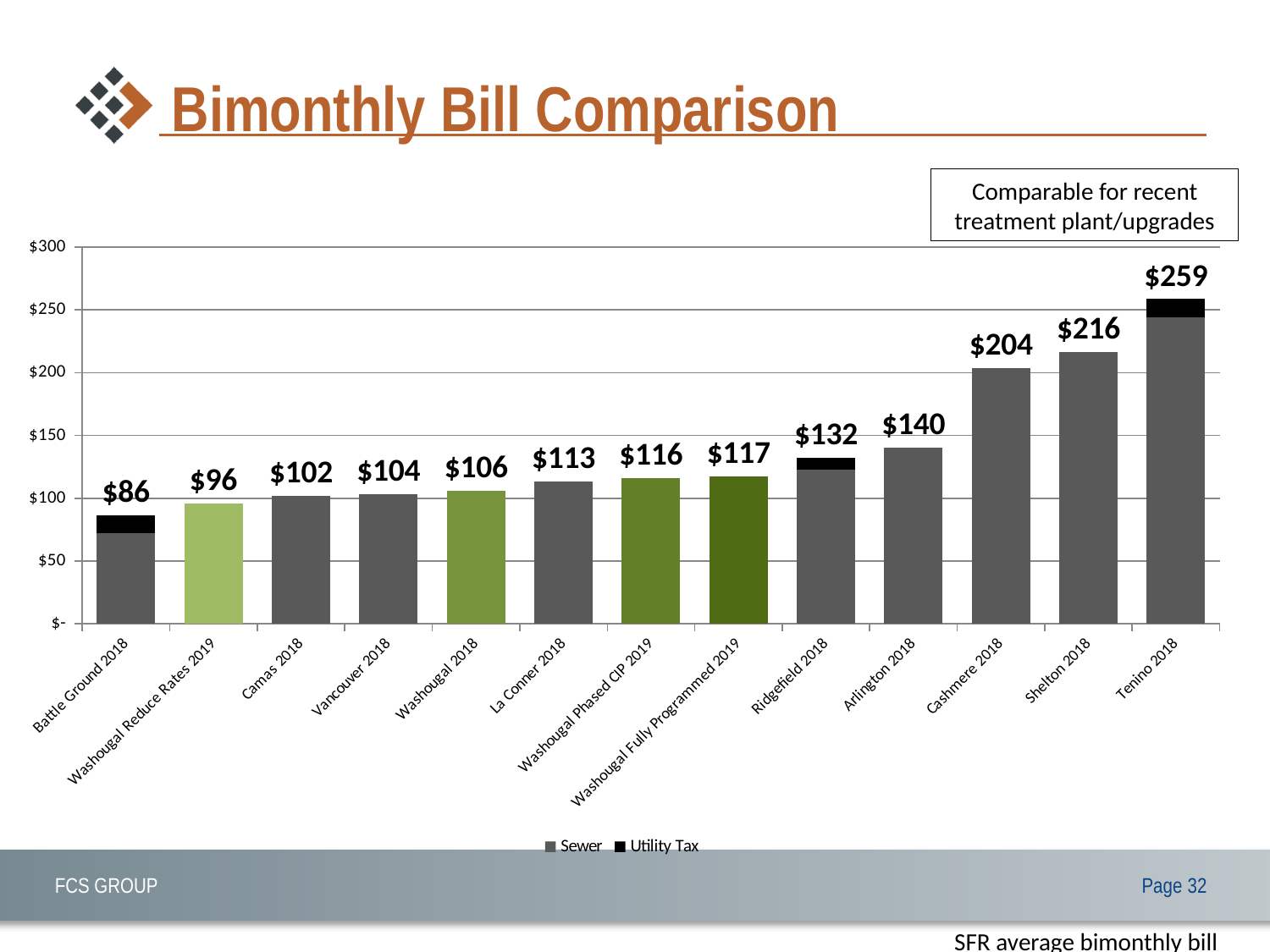
What is the difference between the total bills for Shelton 2018 and Cashmere 2018? $12 Which has a larger total bill, Arlington 2018 or La Conner 2018? Arlington 2018 How many categories are shown on the x axis of the chart? 13 What is the difference between the total bills for Washougal Fully Programmed 2019 and Washougal 2018? $11 What is the total bimonthly bill shown for Tenino 2018? $259 How many series does the chart legend list? 2 What is the total bimonthly bill shown for Ridgefield 2018? $132 What is the total bimonthly bill shown for Washougal Reduce Rates 2019? $96 Which category has the lowest total bimonthly bill? Battle Ground 2018 Which category has the highest total bimonthly bill? Tenino 2018 What type of chart is shown on the slide? Stacked bar chart Is the total bill for Cashmere 2018 greater or less than $150? greater